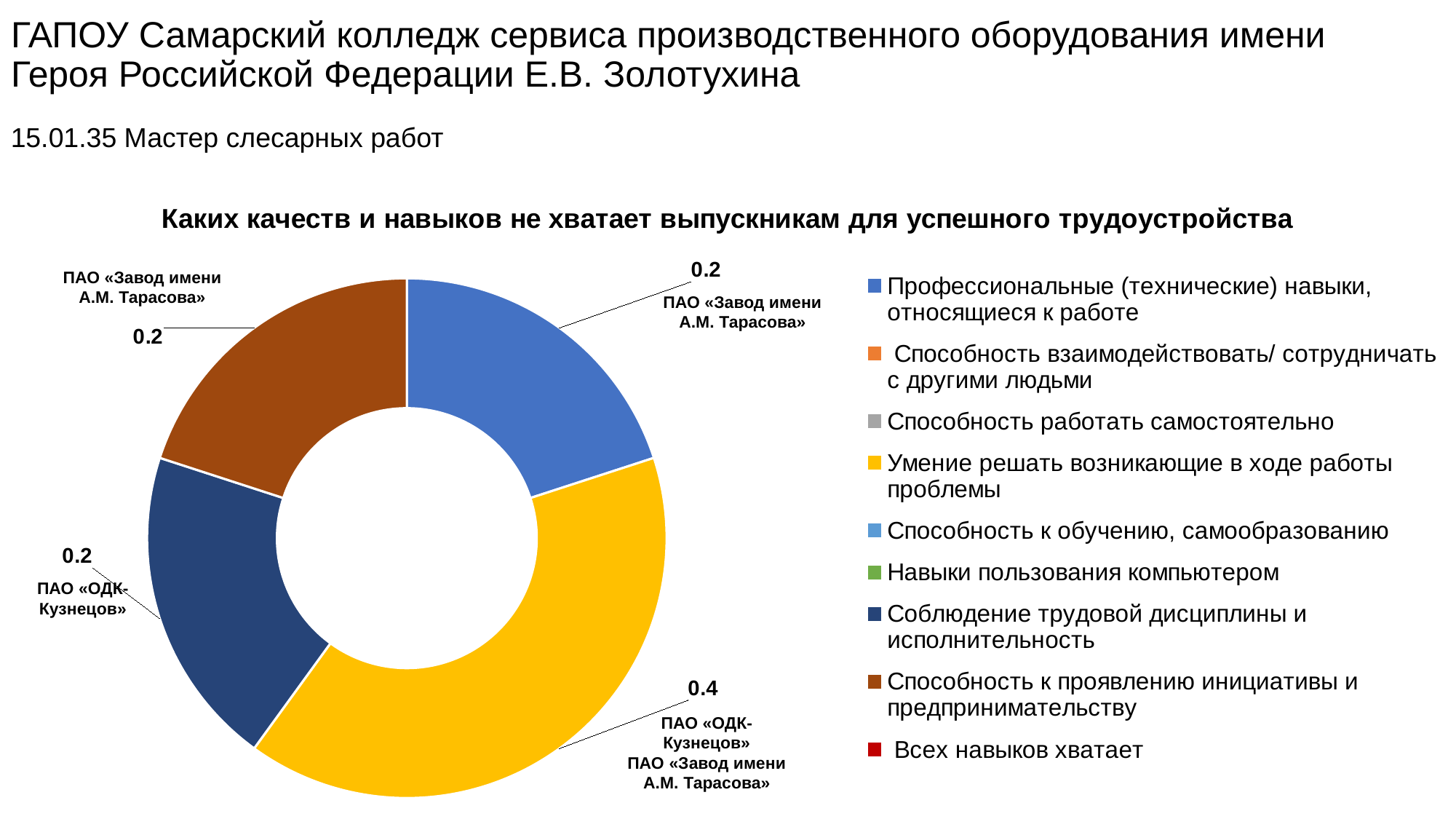
What is the value for «Соблюдение трудовой дисциплины и исполнительность»? 0.2 What is the title of the chart? Каких качеств и навыков не хватает выпускникам для успешного трудоустройства Which is larger: the slice for «Умение решать возникающие в ходе работы проблемы» or the slice for «Способность к проявлению инициативы и предпринимательству»? Умение решать возникающие в ходе работы проблемы What is the value for «Умение решать возникающие в ходе работы проблемы»? 0.4 What is the difference between the value for «Умение решать возникающие в ходе работы проблемы» and the value for «Соблюдение трудовой дисциплины и исполнительность»? 0.2 What colour is the slice for «Умение решать возникающие в ходе работы проблемы»? Yellow What is the value for «Профессиональные (технические) навыки, относящиеся к работе»? 0.2 Which category has the largest slice in the chart? Умение решать возникающие в ходе работы проблемы What kind of chart is shown on the slide? Doughnut (pie) chart How many slices are visible in the doughnut chart? 4 What is the value for «Способность к проявлению инициативы и предпринимательству»? 0.2 How many entries does the chart legend list? 9